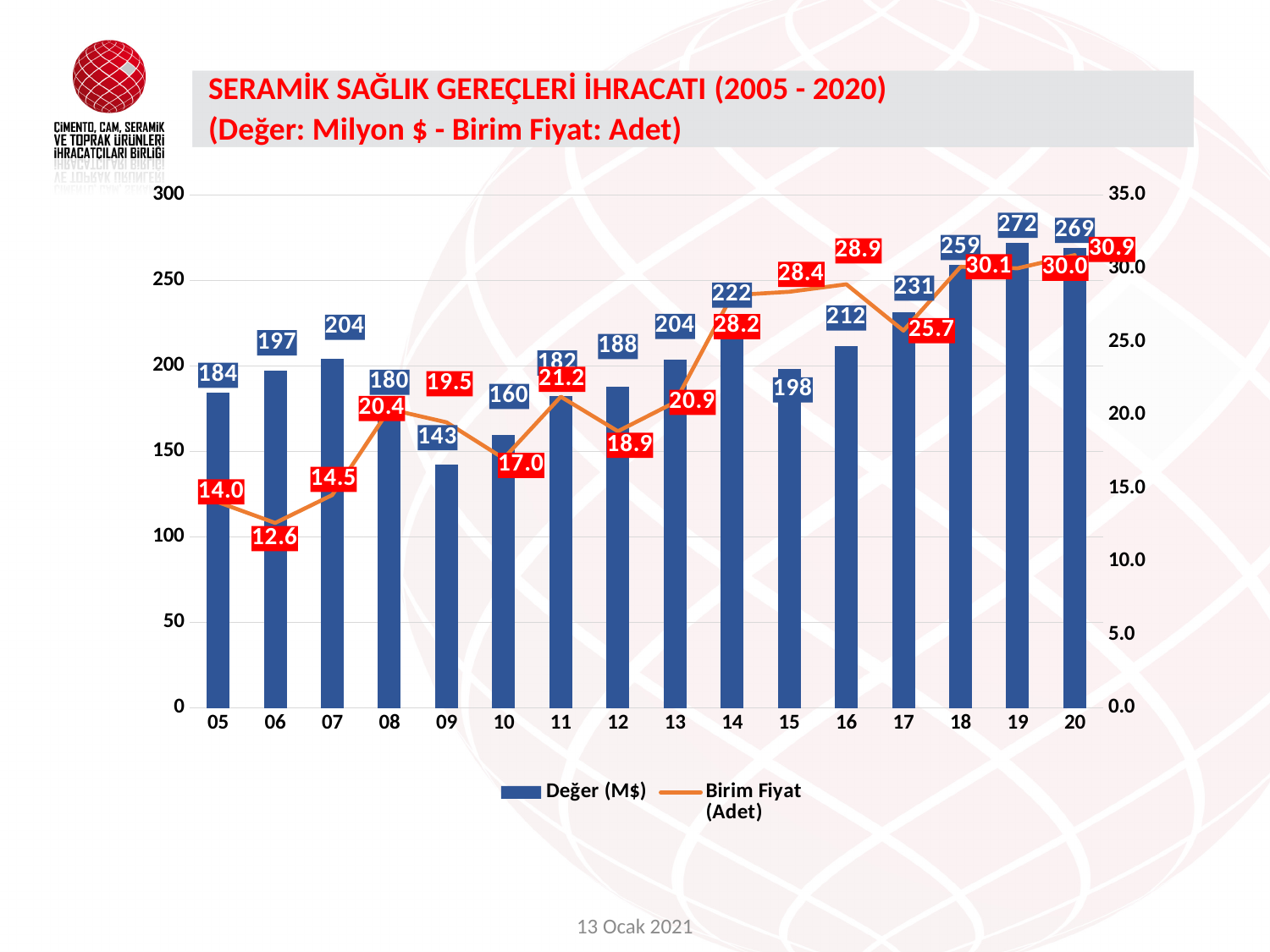
What is the Değer (M$) value for 19? 272 What is the difference between the Değer (M$) values for 18 and 17? 28 What is the Birim Fiyat (Adet) value for 06? 12.6 Which year has the lowest Birim Fiyat (Adet) value? 06 What kind of chart is shown on the slide? Combined bar and line chart How many series does the legend list? 2 What is the difference between the Birim Fiyat (Adet) values for 20 and 05? 16.9 Which is larger, the Değer (M$) value for 14 or for 16? 14 What is the Değer (M$) value for 09? 143 How many years are shown on the x axis? 16 Which year has the highest Birim Fiyat (Adet) value? 20 Which year has the highest Değer (M$) value? 19